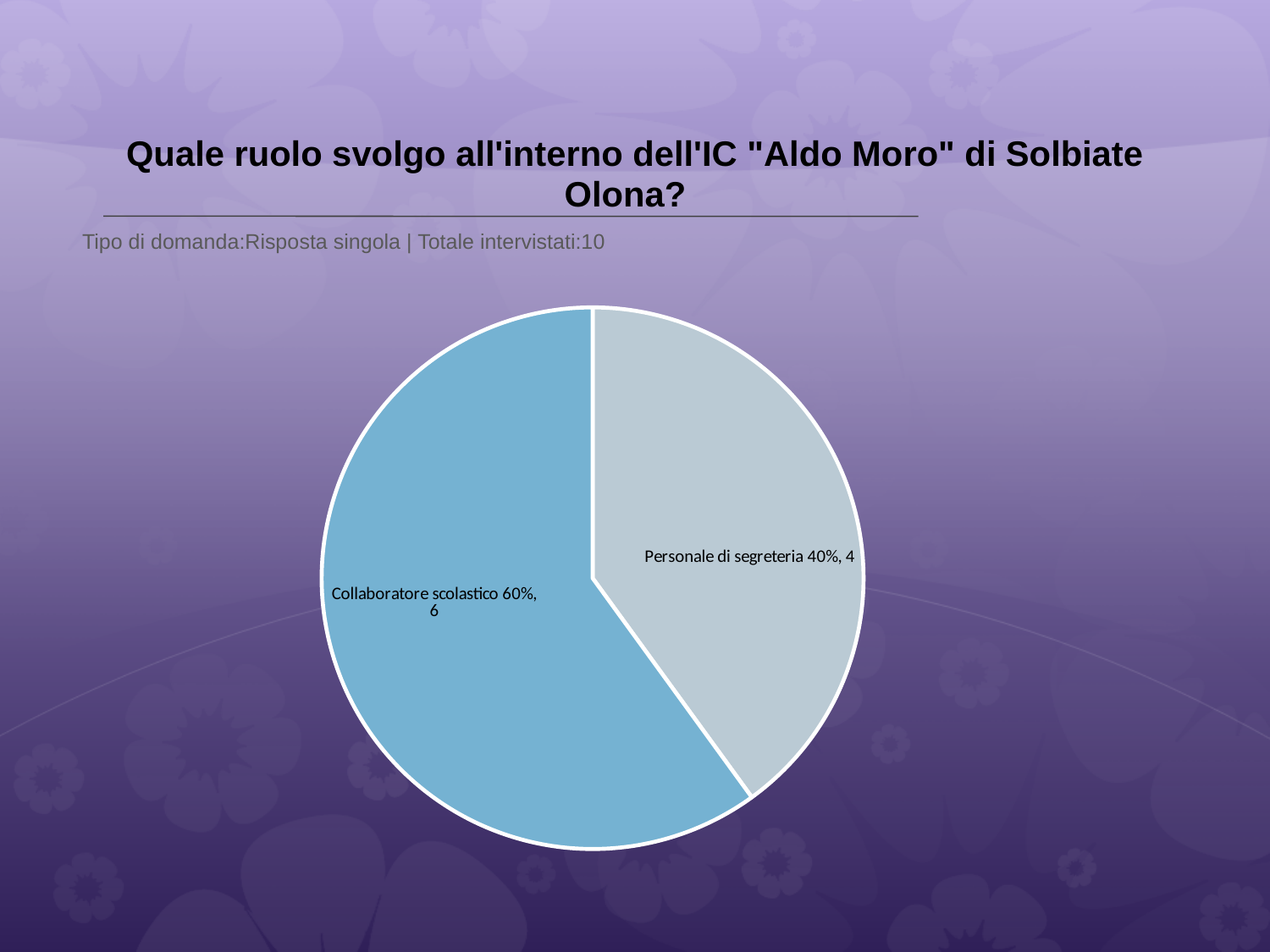
How many respondents are Collaboratore scolastico? 6 What percentage share does the Collaboratore scolastico slice have? 60% Which category has the largest slice of the pie? Collaboratore scolastico What percentage share does the Personale di segreteria slice have? 40% What kind of chart is shown on the slide? pie chart Which is larger: the Collaboratore scolastico slice or the Personale di segreteria slice? Collaboratore scolastico What is the difference in respondent count between Collaboratore scolastico and Personale di segreteria? 2 How many respondents are Personale di segreteria? 4 What is the total number of respondents across both slices? 10 How many slices does the pie chart have? 2 What is the title of the chart on the slide? Quale ruolo svolgo all'interno dell'IC "Aldo Moro" di Solbiate Olona? Which category has the smallest slice of the pie? Personale di segreteria